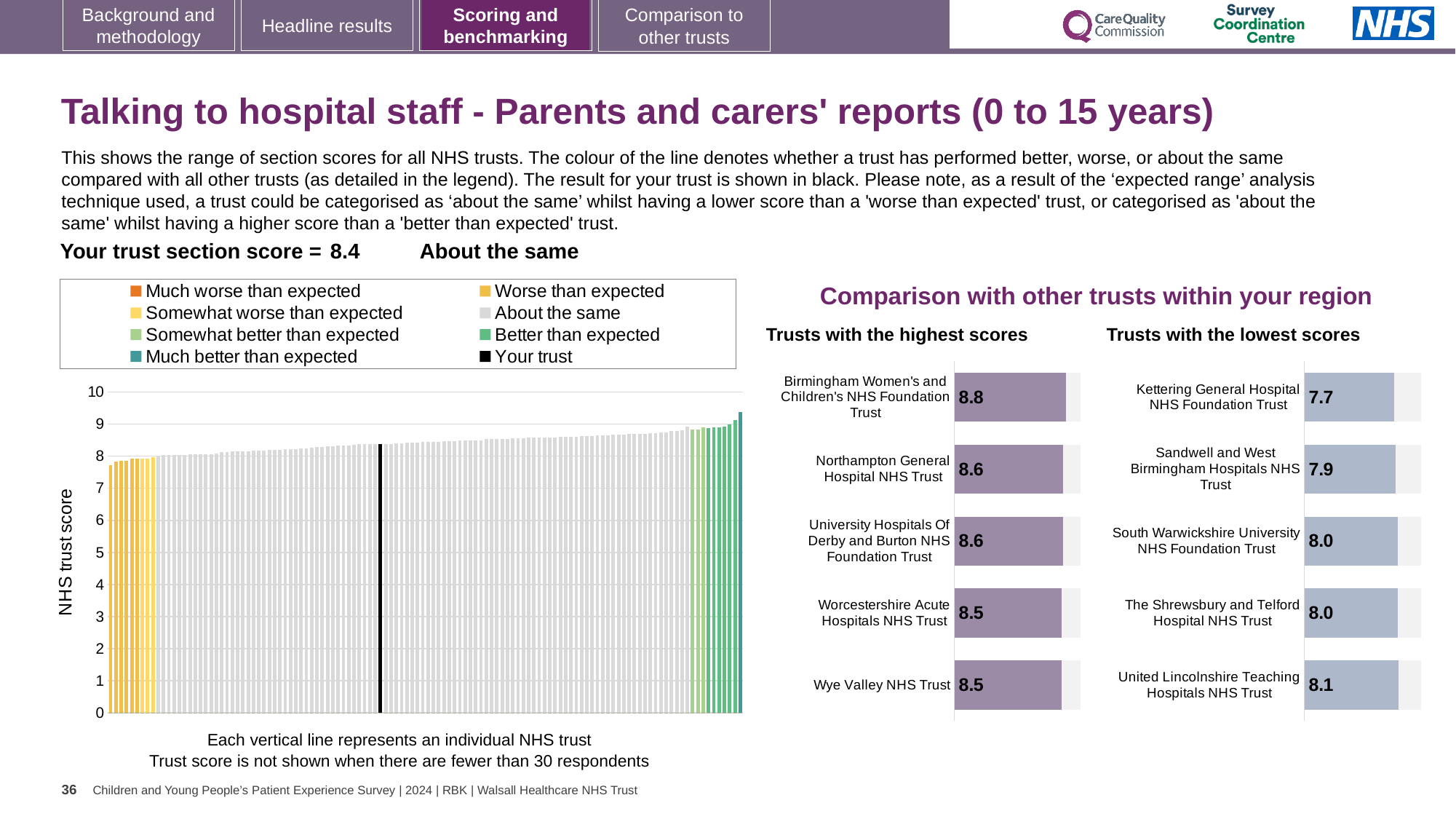
In the 'Trusts with the lowest scores' chart, which trust has the lowest score? Kettering General Hospital NHS Foundation Trust In the main chart on the left, is the value for 'Your trust' greater or less than 8? greater In the 'Trusts with the highest scores' chart, what is the difference between the scores of Birmingham Women's and Children's NHS Foundation Trust and Wye Valley NHS Trust? 0.3 In the 'Trusts with the lowest scores' chart, what is the difference between the scores of United Lincolnshire Teaching Hospitals NHS Trust and Kettering General Hospital NHS Foundation Trust? 0.4 How many trusts are shown in the 'Trusts with the highest scores' chart? 5 In the 'Trusts with the highest scores' chart, which trust has the highest score? Birmingham Women's and Children's NHS Foundation Trust What is the y-axis label of the main chart on the left? NHS trust score In the 'Trusts with the lowest scores' chart, what is the score for Kettering General Hospital NHS Foundation Trust? 7.7 What kind of chart is the main chart on the left showing all NHS trusts? Bar chart In the 'Trusts with the highest scores' chart, what is the score for Birmingham Women's and Children's NHS Foundation Trust? 8.8 How many entries does the legend of the main chart on the left list? 8 In the 'Trusts with the lowest scores' chart, which has the larger score: Sandwell and West Birmingham Hospitals NHS Trust or Kettering General Hospital NHS Foundation Trust? Sandwell and West Birmingham Hospitals NHS Trust